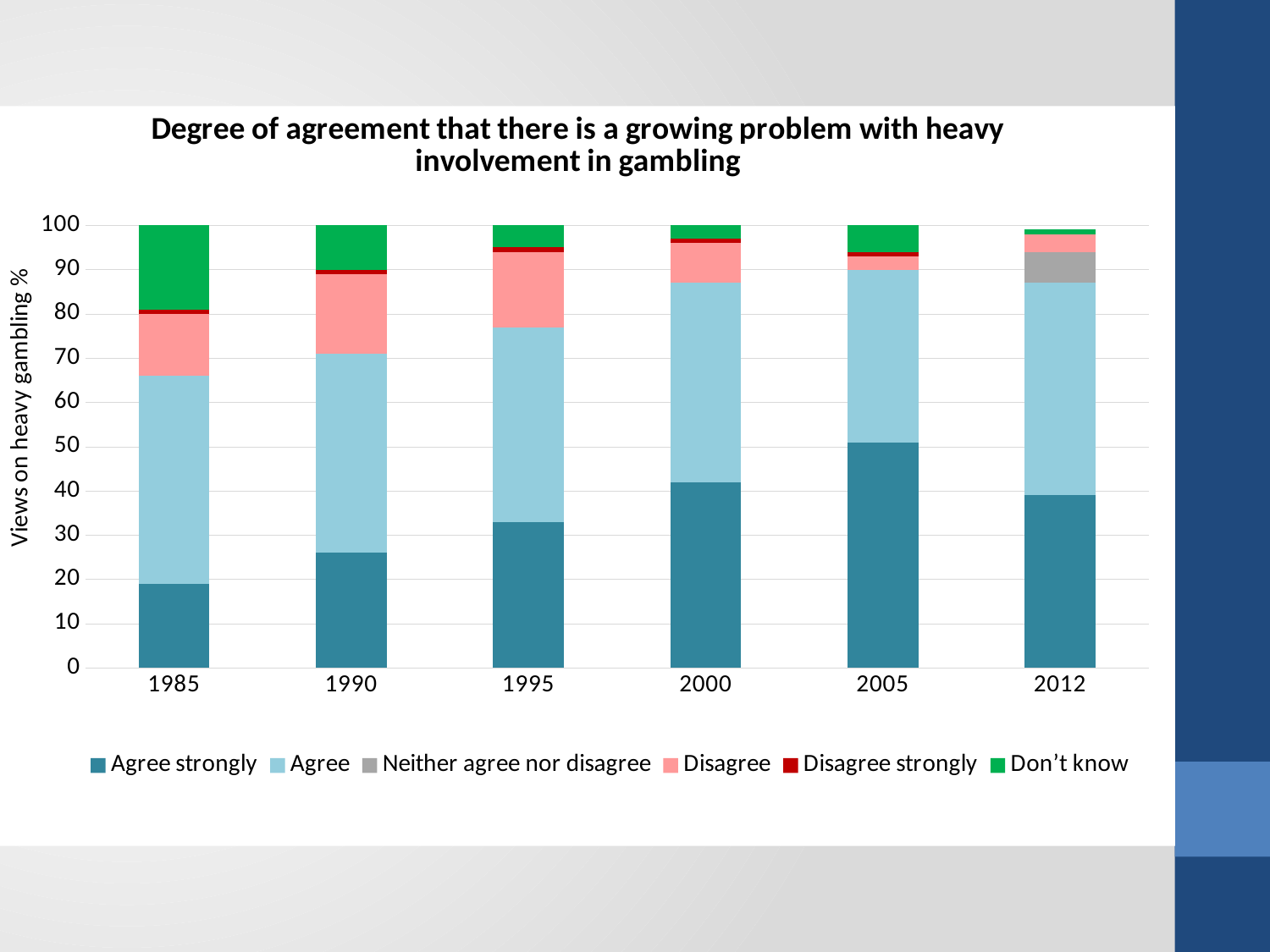
How many years are shown along the x axis? 6 Which year has the largest 'Agree strongly' segment? 2005 How many series does the legend list? 6 Does the 'Agree strongly' segment rise or fall from 1985 to 2005? rise Which year has the largest 'Don't know' segment? 1985 Is the 'Agree strongly' value for 2005 greater or less than 40? greater In which year does the 'Neither agree nor disagree' segment appear? 2012 Is the 'Agree strongly' value for 2012 greater or less than 50? less Is the 'Agree strongly' value for 1985 greater or less than 30? less Which year has the smallest 'Agree strongly' segment? 1985 Which is larger, the 'Agree strongly' segment for 2005 or for 2012? 2005 What kind of chart is shown on the slide? Stacked bar chart